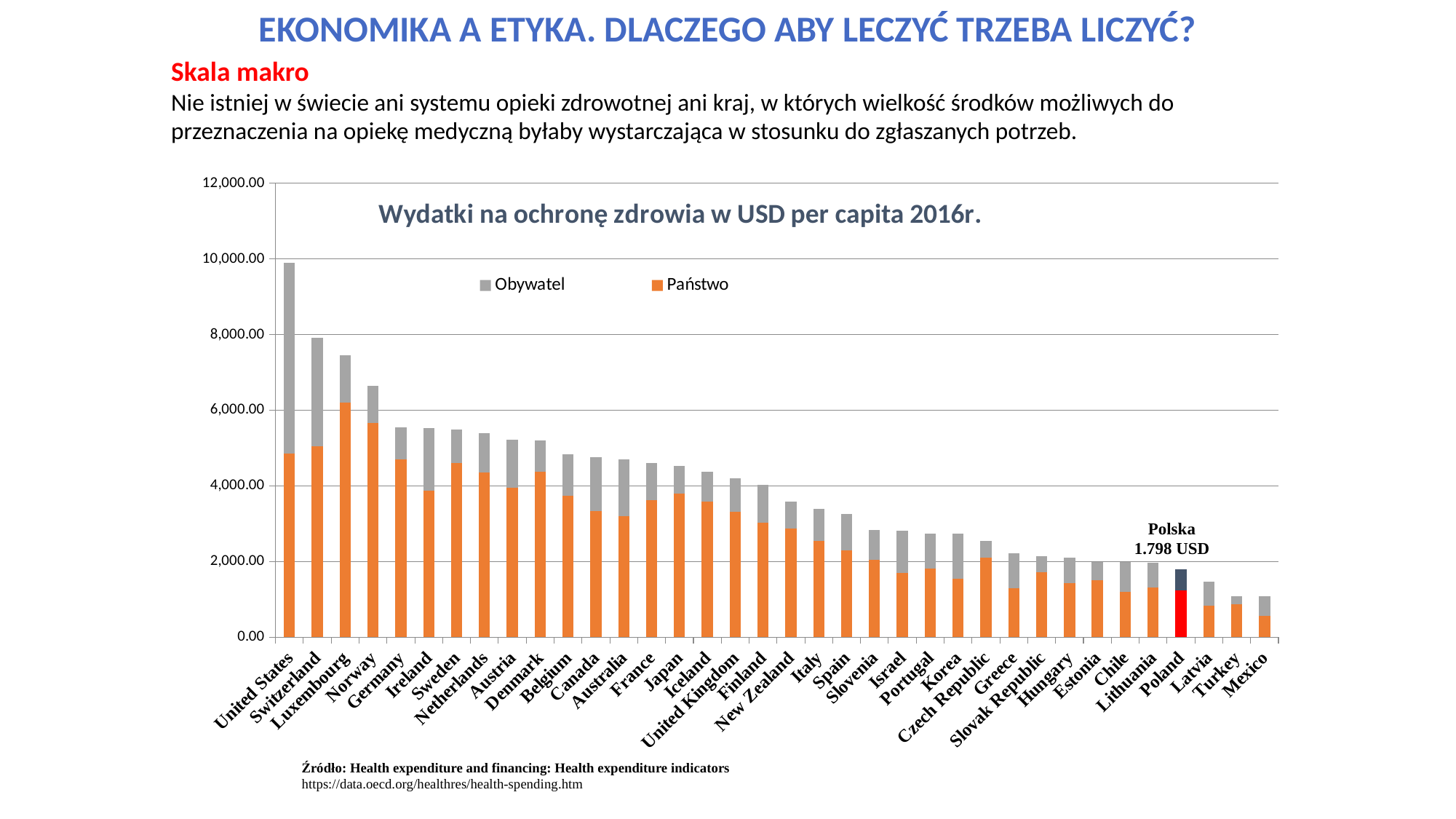
Which country has the largest Państwo (orange) portion? Luxembourg What kind of chart is shown on the slide? Bar chart Is the total value for the United States greater or less than 8,000.00? greater Do the total values rise or fall from left to right along the x axis? Fall Which country has the highest total health expenditure per capita? United States Is the total value for Germany greater or less than 6,000.00? less What value is annotated for Poland (Polska) on the chart? 1.798 USD Which has a larger total value, Norway or Germany? Norway How many countries are shown on the x axis? 36 What are the two legend entries of the chart? Obywatel and Państwo How many series does the legend list? 2 Is the total value for Mexico greater or less than 2,000.00? less